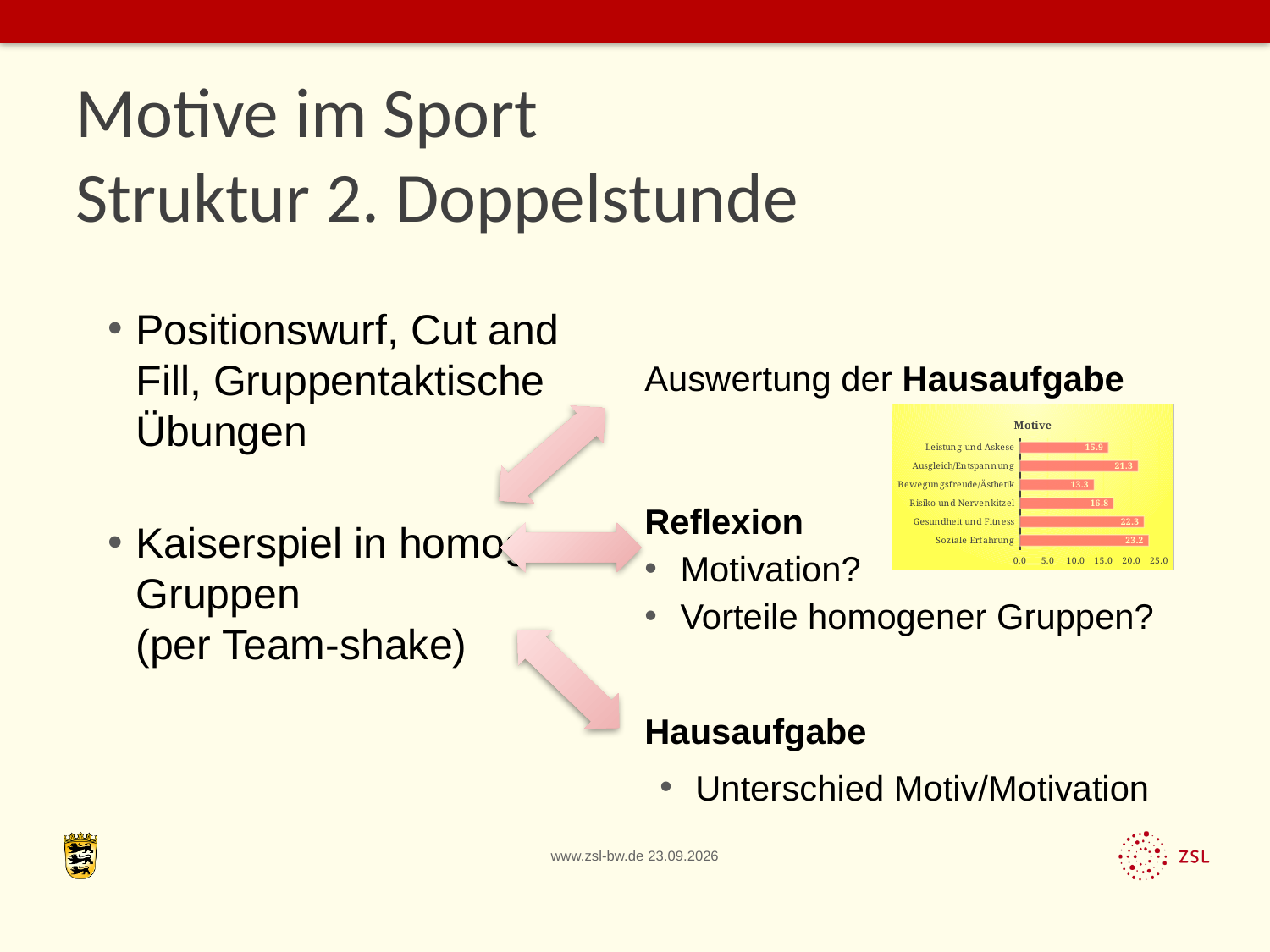
What is the value for Leistung und Askese in the Motive chart? 15.9 What is the value for Bewegungsfreude/Ästhetik in the Motive chart? 13.3 What kind of chart is shown on the slide? bar chart What is the difference between the values for Soziale Erfahrung and Bewegungsfreude/Ästhetik in the Motive chart? 9.9 Which category has the highest value in the Motive chart? Soziale Erfahrung Which category has the lowest value in the Motive chart? Bewegungsfreude/Ästhetik What is the value for Gesundheit und Fitness in the Motive chart? 22.3 How many categories does the Motive chart show? 6 What is the title of the chart on the slide? Motive Which is larger in the Motive chart, Ausgleich/Entspannung or Risiko und Nervenkitzel? Ausgleich/Entspannung What is the value for Risiko und Nervenkitzel in the Motive chart? 16.8 What is the value for Ausgleich/Entspannung in the Motive chart? 21.3